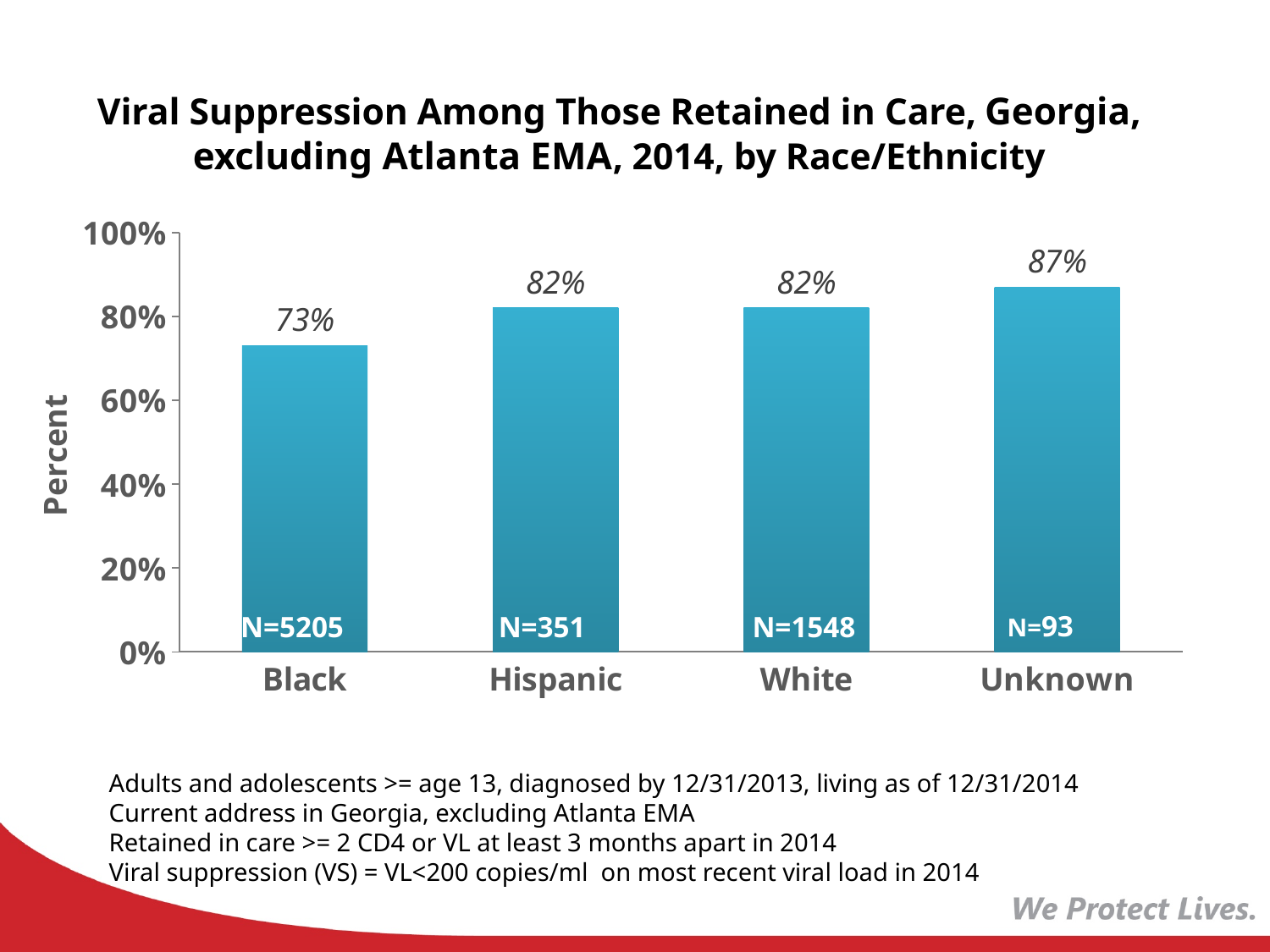
What is the viral suppression percentage for Black? 73% How many race/ethnicity categories are shown in the chart? 4 What is the N value shown on the White bar? N=1548 What is the difference in viral suppression percentage between Unknown and Black? 14% Which race/ethnicity category has the highest viral suppression percentage? Unknown What is the viral suppression percentage for Unknown? 87% What kind of chart is shown on the slide? Bar chart What is the label on the vertical axis of the chart? Percent What is the viral suppression percentage for Hispanic? 82% Which race/ethnicity category has the lowest viral suppression percentage? Black Is the value for Black greater or less than 80%? less Which has a higher viral suppression percentage, Black or White? White